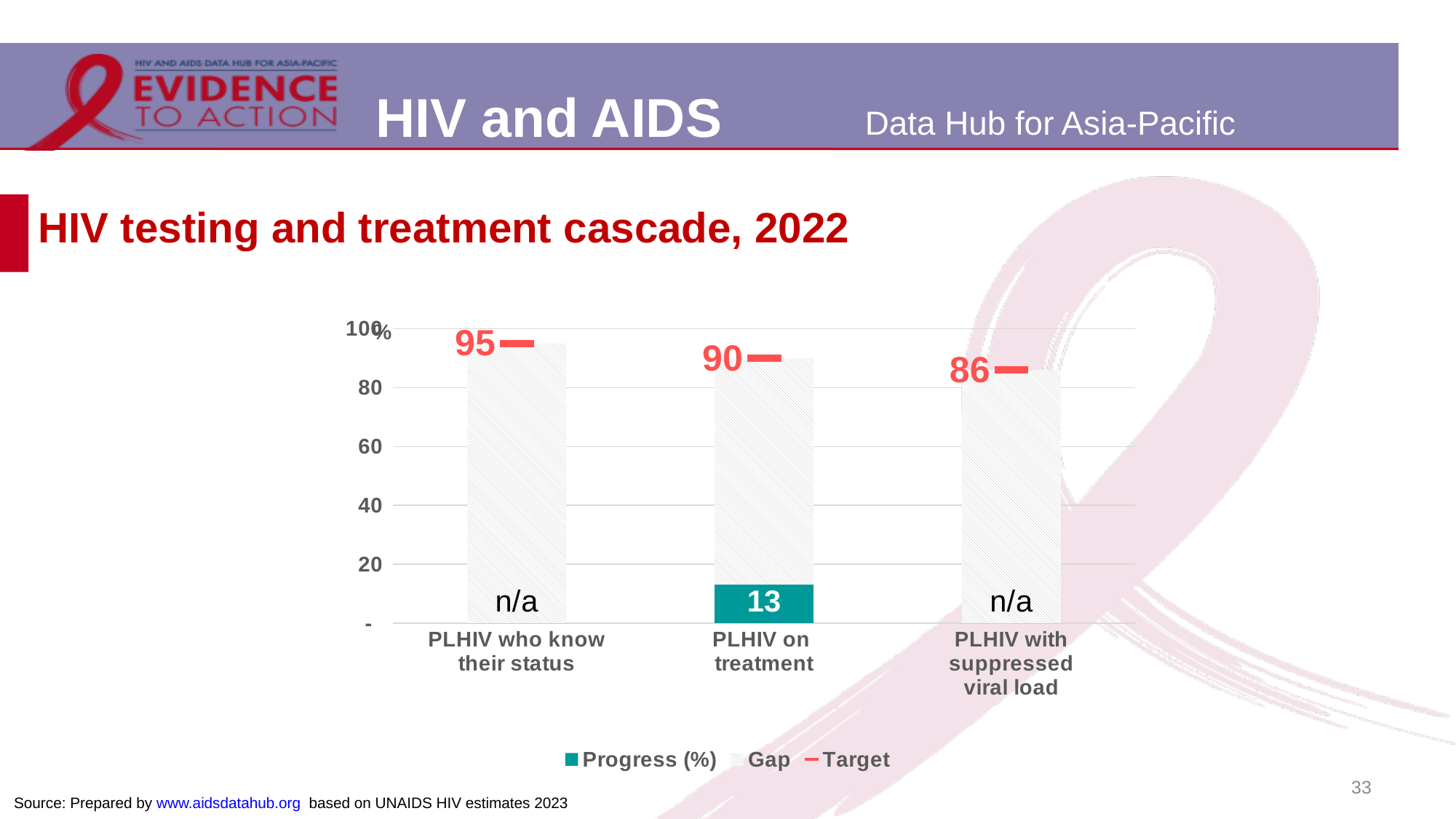
Which category has the highest Target value? PLHIV who know their status What is the Target value for PLHIV on treatment? 90 How many categories are shown on the x axis? 3 Which category has the lowest Target value? PLHIV with suppressed viral load What is the Target value for PLHIV with suppressed viral load? 86 Is the Target for PLHIV on treatment greater or less than 80? greater What kind of chart is shown on the slide? bar chart What is the Target value for PLHIV who know their status? 95 How many series does the legend list? 3 What is the difference between the Target for PLHIV who know their status and the Target for PLHIV with suppressed viral load? 9 What is the Progress (%) value for PLHIV on treatment? 13 What is the Progress (%) value shown for PLHIV with suppressed viral load? n/a